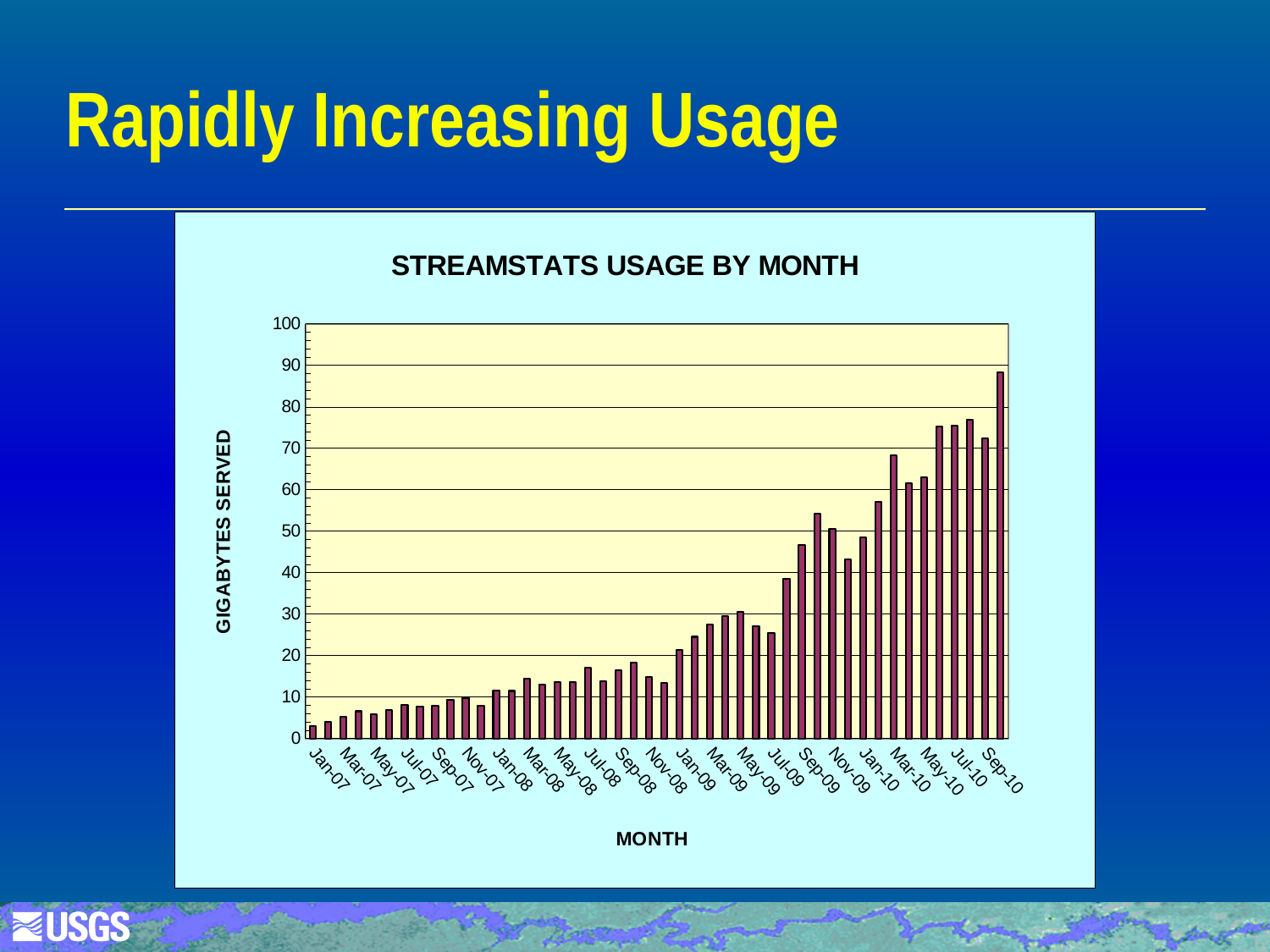
Which month has the lowest value in the chart? Jan-07 Is the value for Jan-07 greater or less than 10? less Is the value for Jul-09 greater or less than 30? less Which is larger, the value for Sep-09 or the value for Sep-08? Sep-09 Is the value for Mar-10 greater or less than 60? greater What is the label on the vertical axis of the chart? GIGABYTES SERVED What is the title of the chart? STREAMSTATS USAGE BY MONTH Do the values generally rise or fall from Jan-07 to Sep-10? rise What kind of chart is shown on the slide? bar chart